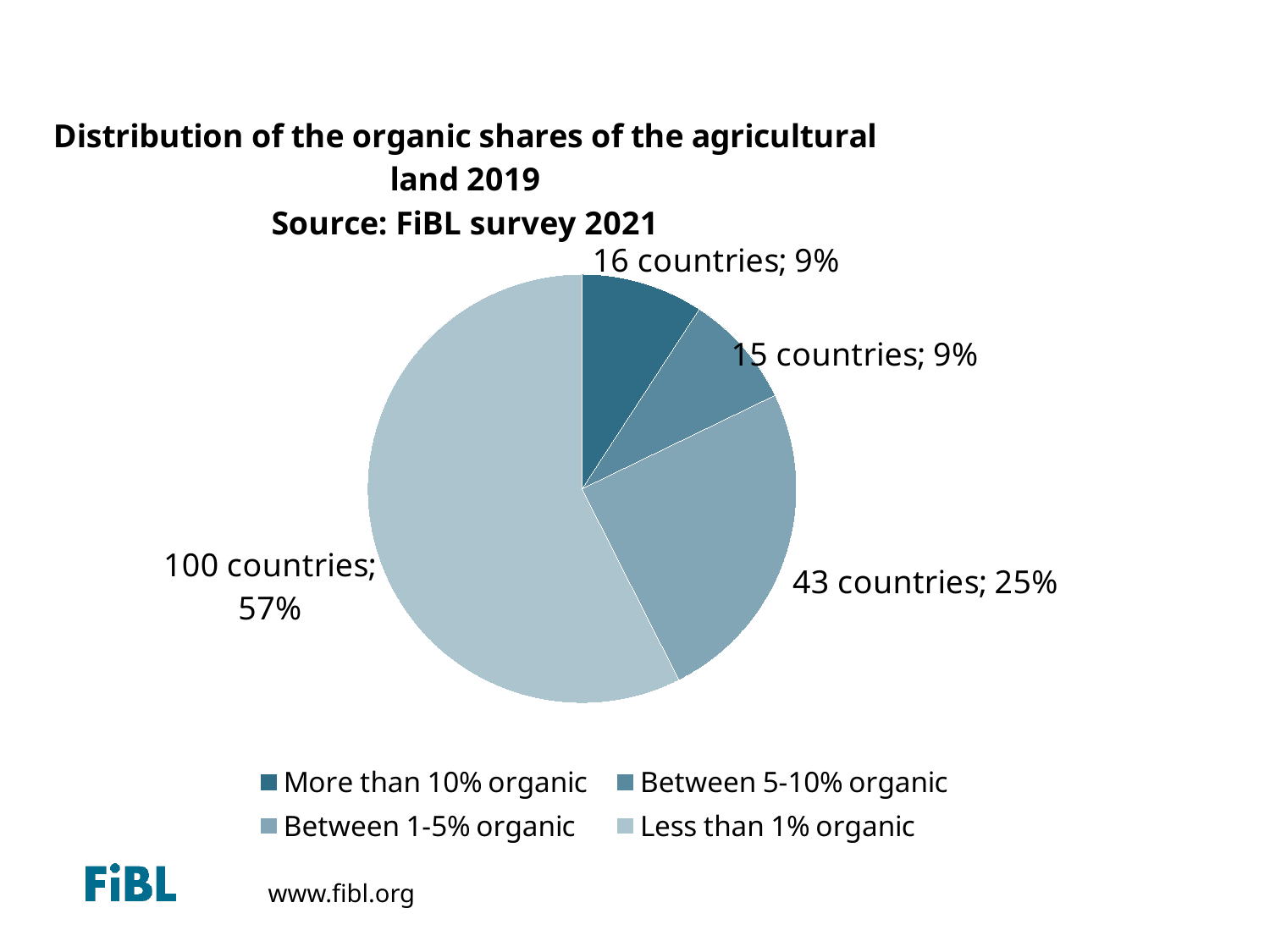
What source is given in the chart title? FiBL survey 2021 What share of the pie is the 'Less than 1% organic' slice? 57% How many slices does the pie chart have? 4 How many countries have less than 1% organic agricultural land? 100 countries Which category has the largest number of countries? Less than 1% organic How many entries does the legend list? 4 Which category has the smallest number of countries? Between 5-10% organic What kind of chart is shown on the slide? Pie chart What share of the pie is the 'Between 1-5% organic' slice? 25% How many countries are in the 'More than 10% organic' category? 16 countries Which has more countries: 'More than 10% organic' or 'Between 1-5% organic'? Between 1-5% organic How many more countries are in the 'Between 1-5% organic' category than in the 'Between 5-10% organic' category? 28